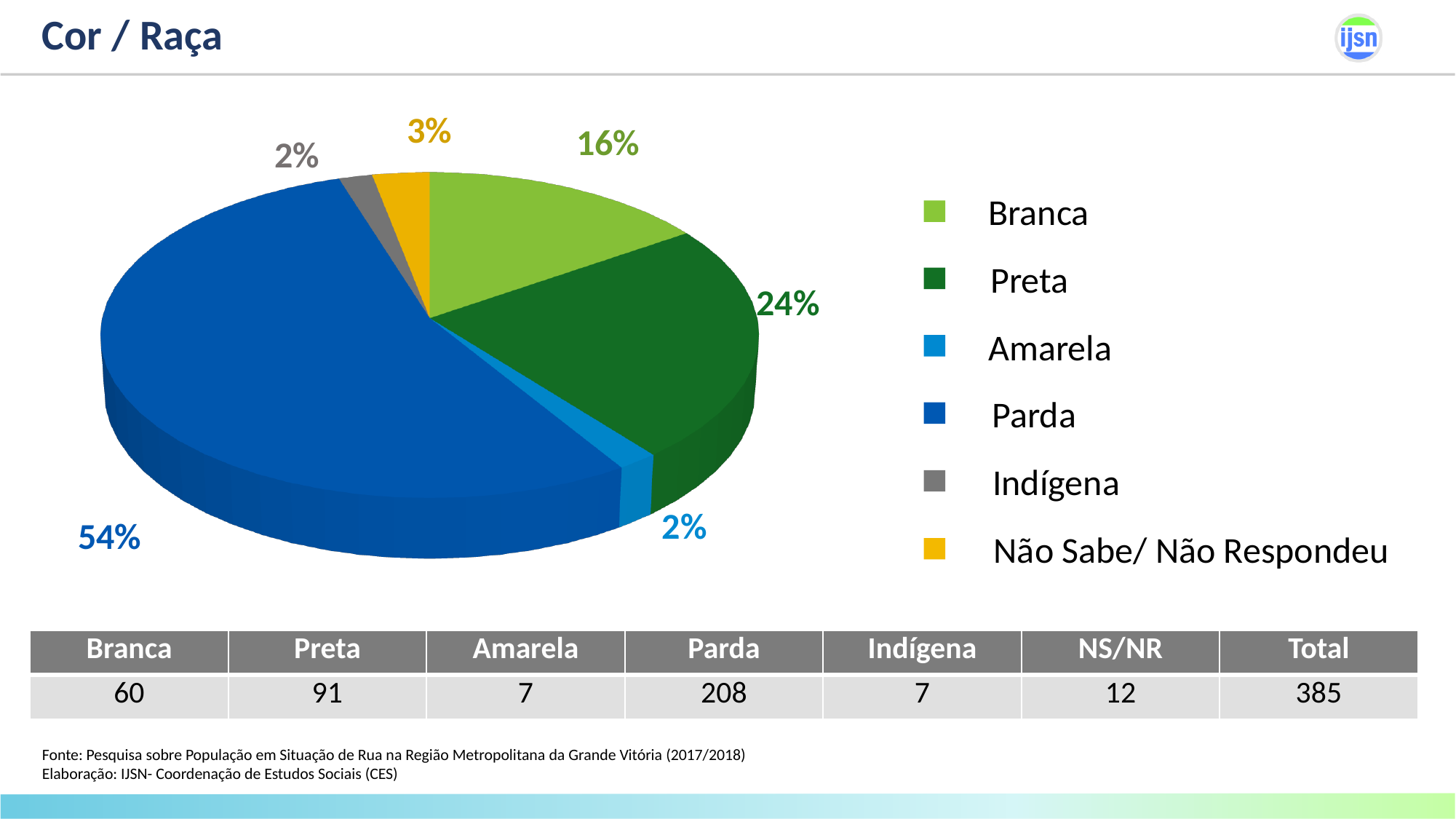
Is the share for Parda greater or less than 50%? greater Which category has the largest slice of the pie? Parda What share of the pie does Não Sabe/ Não Respondeu represent? 3% What is the title of the slide containing the chart? Cor / Raça What is the difference in percentage points between the Parda slice and the Preta slice? 30% What share of the pie does Branca represent? 16% What share of the pie does Preta represent? 24% Which is larger, the slice for Preta or the slice for Branca? Preta What kind of chart is shown on the slide? Pie chart How many categories does the legend list? 6 Which colour represents Indígena in the chart? Grey